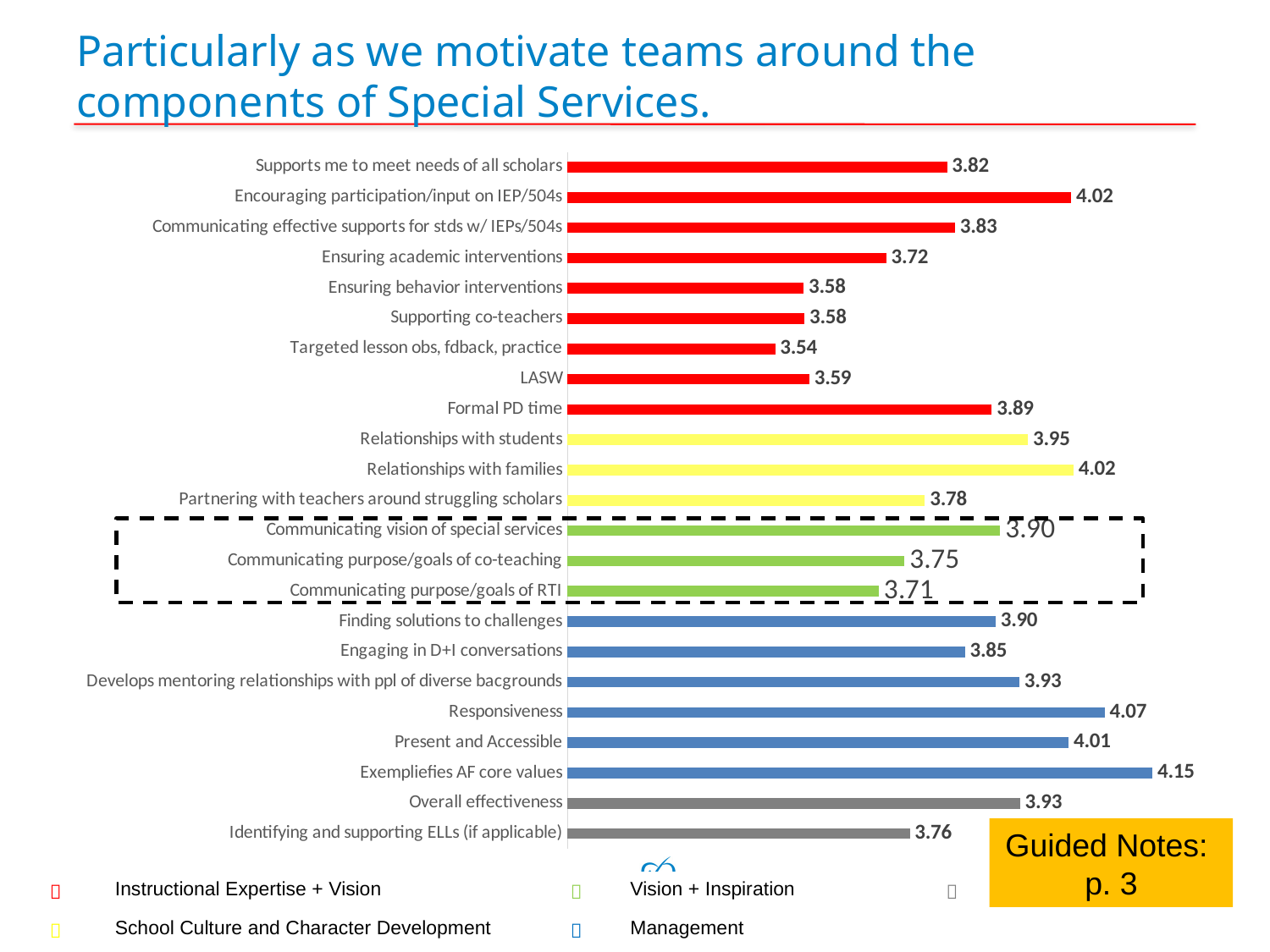
Which has a larger value, Formal PD time or Partnering with teachers around struggling scholars? Formal PD time What is the value for LASW? 3.59 How many categories are plotted in the chart? 23 Which category has the lowest value? Targeted lesson obs, fdback, practice Which category has the highest value? Exempliefies AF core values What is the difference between the values for Exempliefies AF core values and Identifying and supporting ELLs (if applicable)? 0.39 What is the value for Responsiveness? 4.07 What is the value for Communicating purpose/goals of RTI? 3.71 What is the difference between the values for Encouraging participation/input on IEP/504s and Ensuring academic interventions? 0.30 What kind of chart is shown on the slide? Bar chart Which has a larger value, Present and Accessible or Engaging in D+I conversations? Present and Accessible What is the value for Overall effectiveness? 3.93